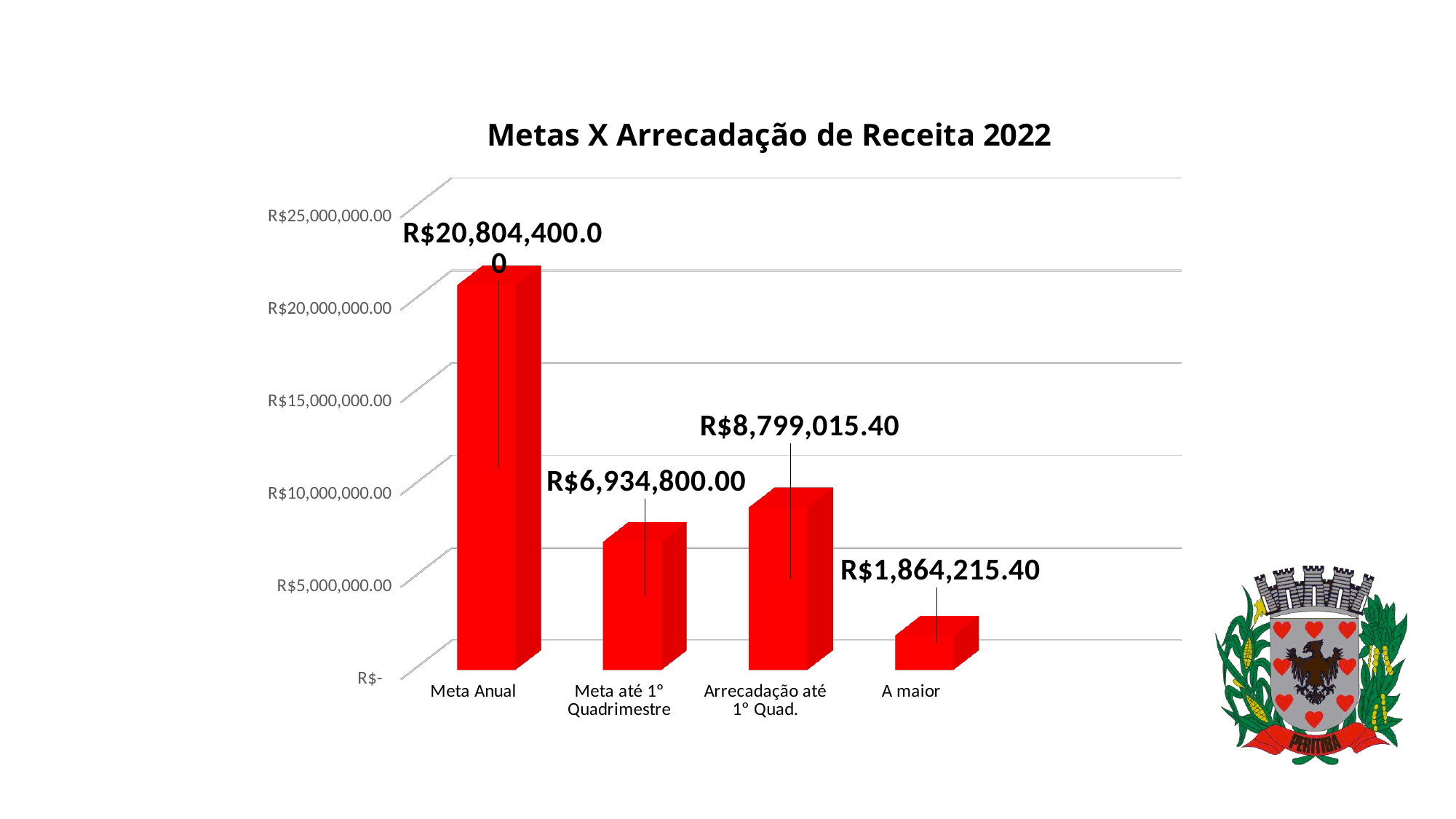
What is the title of the chart? Metas X Arrecadação de Receita 2022 Which category has the highest value? Meta Anual What is the value for A maior? R$1,864,215.40 What is the difference between Arrecadação até 1° Quad. and Meta até 1° Quadrimestre? R$1,864,215.40 How many categories are shown on the chart? 4 What is the difference between Meta Anual and Meta até 1° Quadrimestre? R$13,869,600.00 Which is larger, Arrecadação até 1° Quad. or Meta até 1° Quadrimestre? Arrecadação até 1° Quad. Is the value for Meta Anual greater or less than R$20,000,000.00? greater Which category has the lowest value? A maior What is the value for Meta Anual? R$20,804,400.00 What is the value for Arrecadação até 1° Quad.? R$8,799,015.40 What is the value for Meta até 1° Quadrimestre? R$6,934,800.00